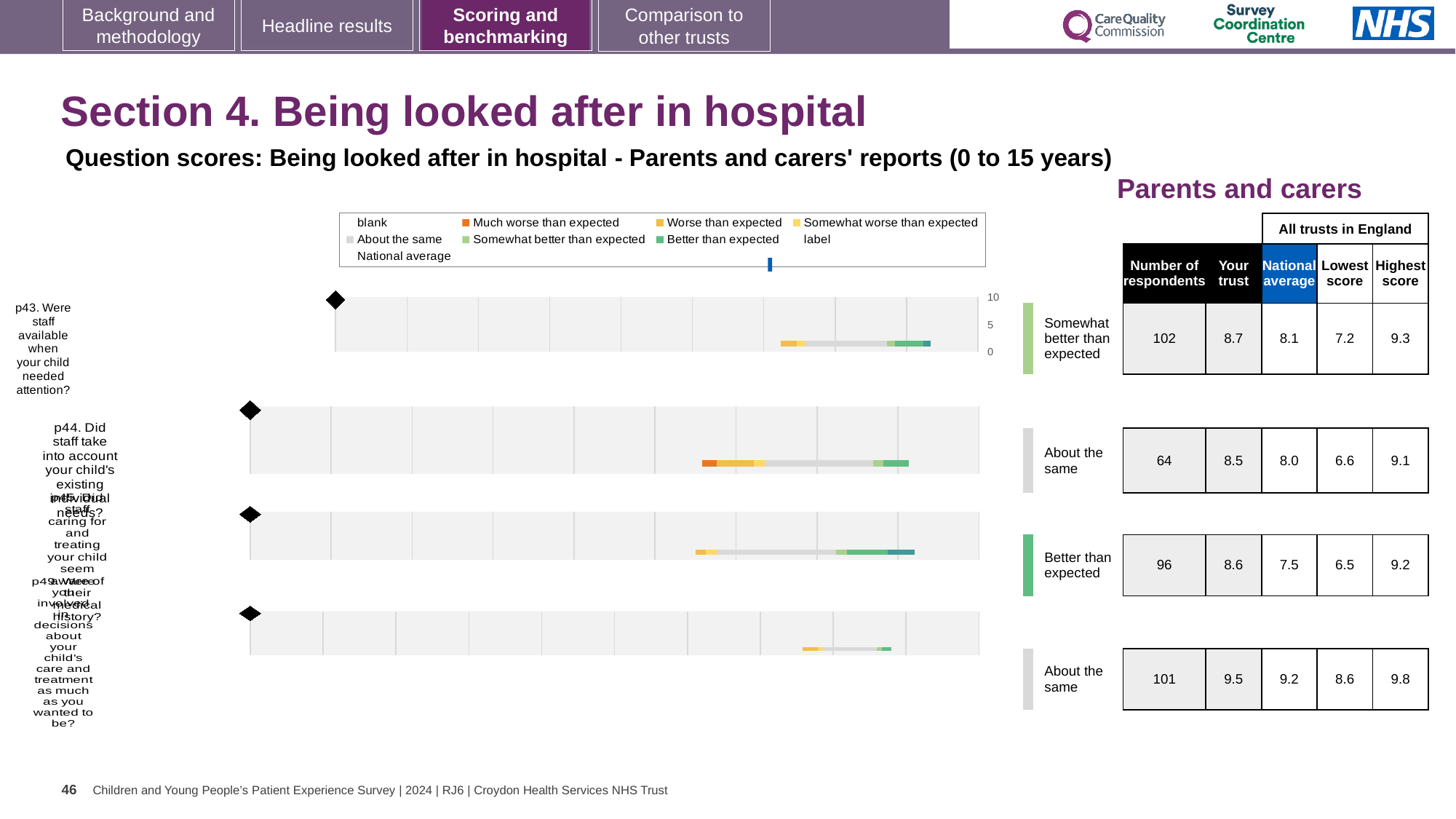
What kind of chart is used to show the benchmarking for each question on this slide? Bar chart For the p43 chart, which is larger: the 'Your trust' score or the national average? Your trust For the fourth (bottom) chart, what is the number of respondents? 101 How many question charts are shown on the slide? 4 Which of the four question charts has the highest 'Your trust' score? The fourth (bottom) chart, 9.5 For the p43 chart (Were staff available when your child needed attention?), what is the number of respondents shown in the table? 102 What benchmark category is shown for the p43 chart? Somewhat better than expected For the p44 chart (Did staff take into account your child's existing individual needs?), what is the 'Your trust' score? 8.5 For the p43 chart, what is the national average score? 8.1 For the p43 chart, what is the difference between the highest score and the lowest score across all trusts in England? 2.1 In the legend, what colour represents 'Much worse than expected'? Orange For the p43 chart, what is the 'Your trust' score? 8.7